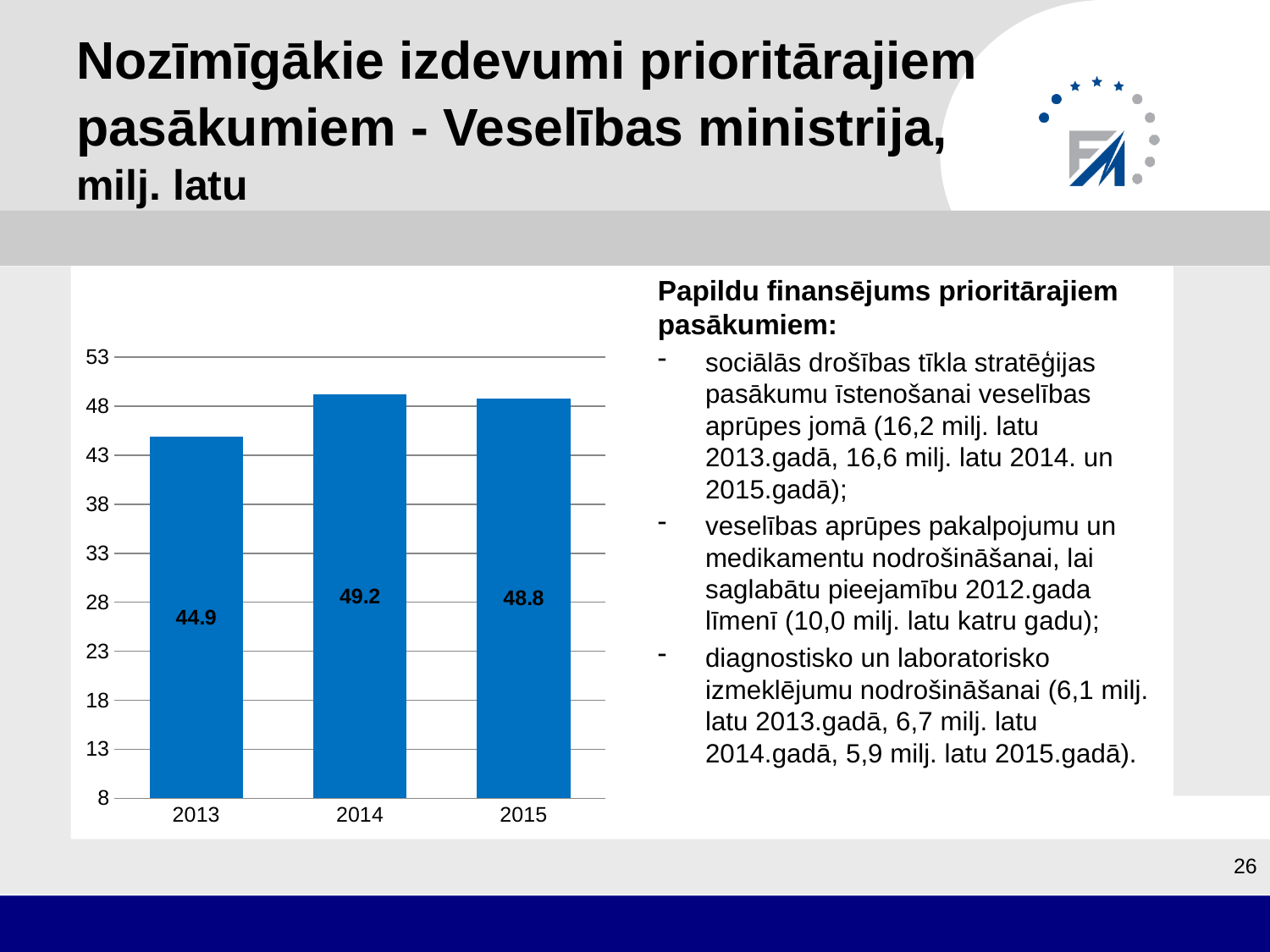
What unit is stated in the slide title for the chart values? milj. latu Is the value for 2013 greater or less than 48? less What is the value for 2014? 49.2 What is the difference between the values for 2014 and 2013? 4.3 Which is larger, the value for 2013 or the value for 2015? 2015 How many years are shown on the x axis? 3 What is the value for 2013? 44.9 Which year has the lowest value? 2013 What is the value for 2015? 48.8 What kind of chart is shown on the slide? bar chart What is the difference between the values for 2014 and 2015? 0.4 Which year has the highest value? 2014